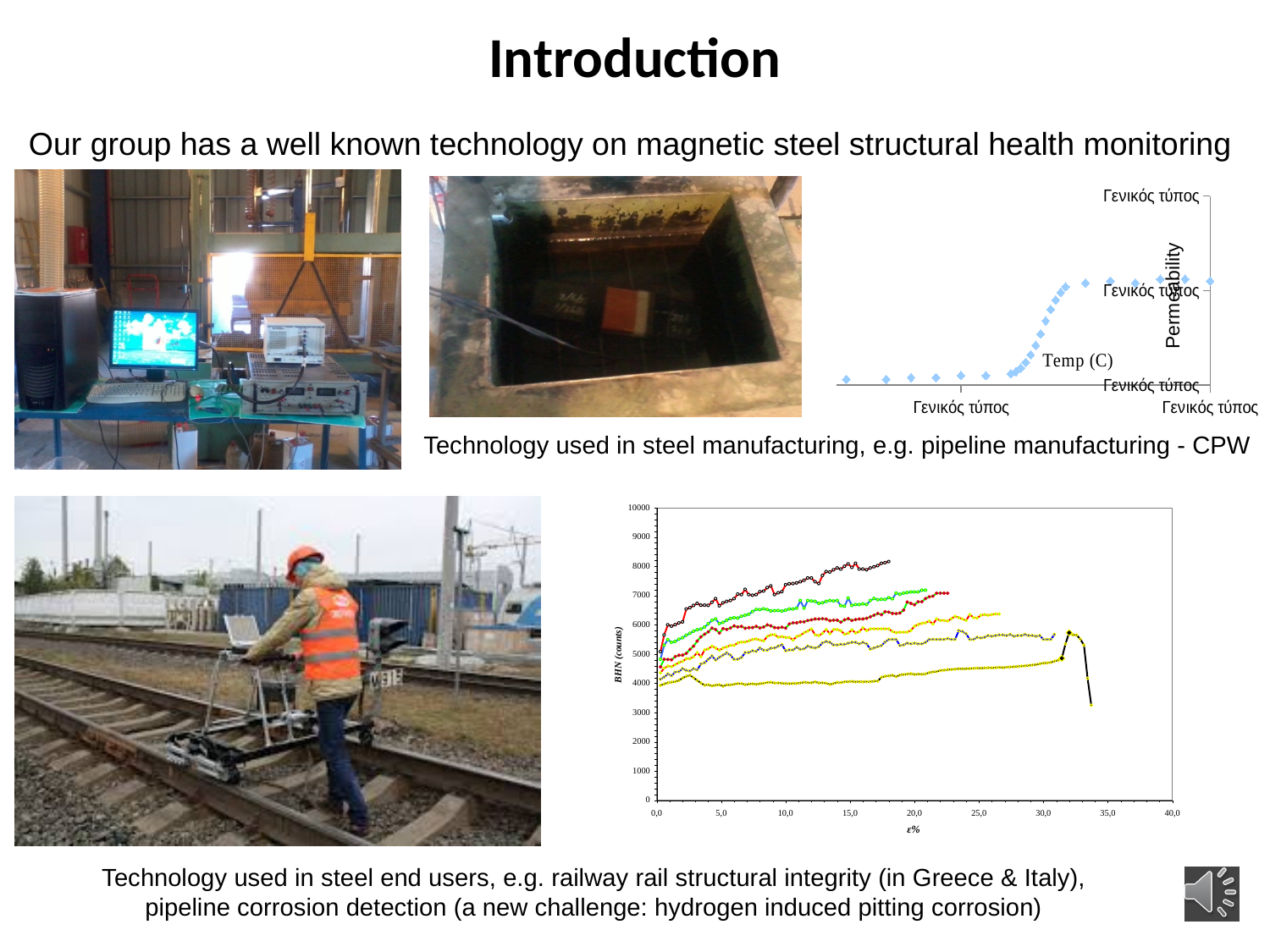
In the bottom-right chart, is the value of the topmost series at ε% = 5,0 greater or less than 6000? greater In the bottom-right chart, is the value of the lowest series at ε% = 10,0 greater or less than 5000? less In the bottom-right chart, what is the maximum value shown on the y axis? 10000 What is the x-axis label of the bottom-right chart? ε% What kind of chart is the chart in the top right of the slide (Permeability vs Temp (C))? scatter chart In the top-right chart, does permeability rise or fall as temperature increases along the x axis? rise In the bottom-right chart, is the highest value reached by the topmost series greater or less than 7000? greater What kind of chart is the chart in the bottom right of the slide (BHN (counts) vs ε%)? line chart In the bottom-right chart, do the BHN (counts) values generally rise or fall as ε% increases from 0,0 to 20,0? rise